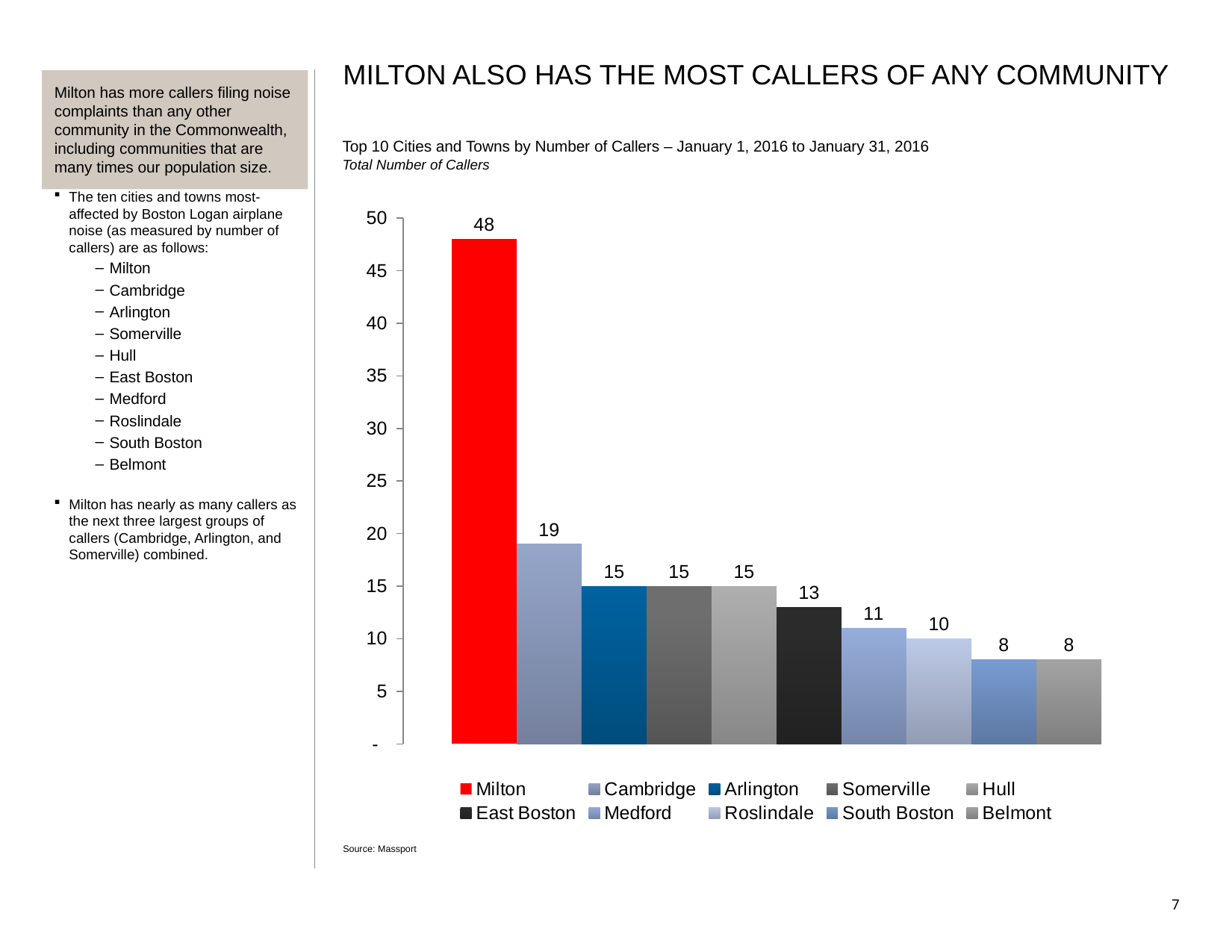
How many entries does the legend list? 10 Is the value for Milton greater or less than 45? greater What is the difference in callers between Milton and Cambridge? 29 Do the values rise or fall from left to right across the chart? Fall What colour is the bar for Milton? Red What is the value shown for East Boston? 13 What is the number of callers for Cambridge? 19 What type of chart is shown on the slide? Bar chart How many callers does Milton have? 48 How many communities are shown in the chart? 10 Which has more callers, Medford or Roslindale? Medford Which community has the most callers? Milton